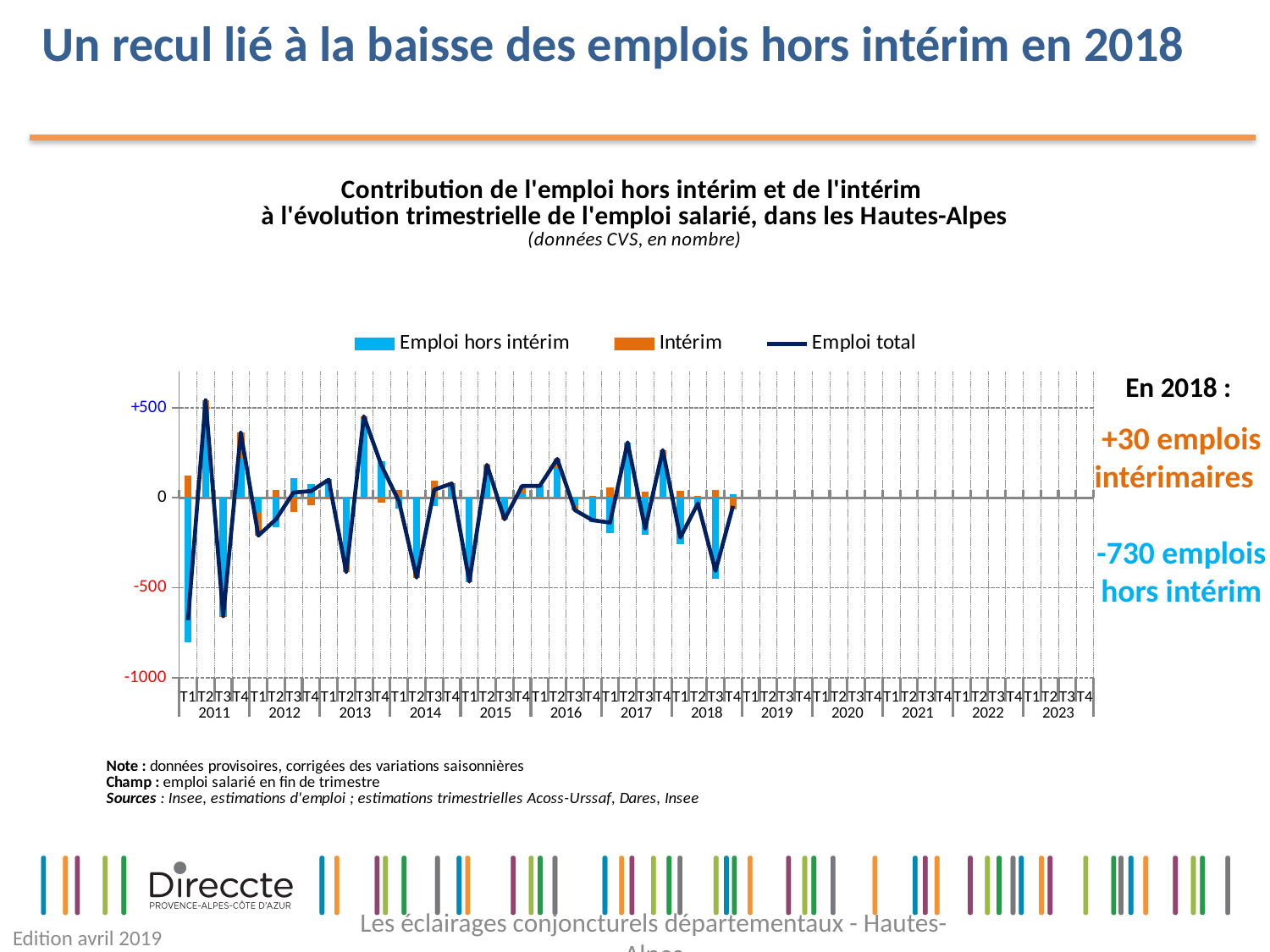
How many series does the legend list? 3 Is the value of Emploi total in T4 2011 greater or less than 0? greater In which quarter does the Emploi total line reach its highest point? T2 2011 Is the value of Emploi hors intérim in T1 2011 greater or less than -500? less Is the value of Emploi total in T2 2013 greater or less than 0? less Which is larger, the Emploi hors intérim value in T1 2011 or in T3 2011? T3 2011 How many years are labelled along the x axis? 13 What kind of chart is shown on the slide? A combined bar and line chart In which quarter is the Emploi hors intérim bar at its lowest? T1 2011 Which series is drawn as a line rather than bars? Emploi total